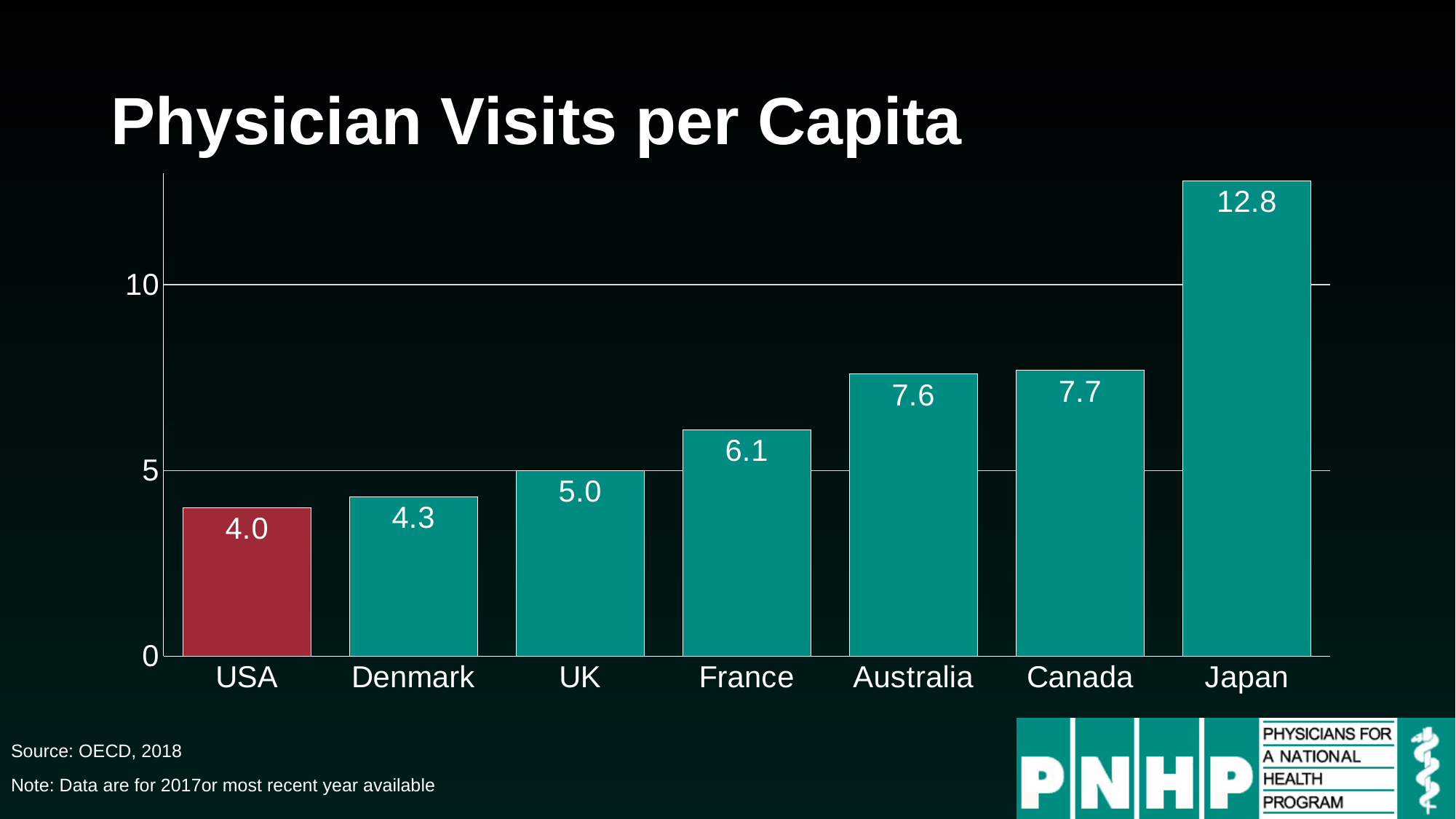
How many countries are shown in the chart? 7 What is the difference between Japan's and the USA's values? 8.8 Which country has the highest physician visits per capita? Japan What is the value for the USA? 4.0 What is the value for France? 6.1 What is the value for Japan? 12.8 What kind of chart is shown on the slide? Bar chart Is the value for Canada greater or less than 5? greater Which country has the lowest physician visits per capita? USA Which is larger, the value for France or the value for Denmark? France What is the difference between Australia's and Denmark's values? 3.3 Which country's bar is coloured differently (red) from the others? USA